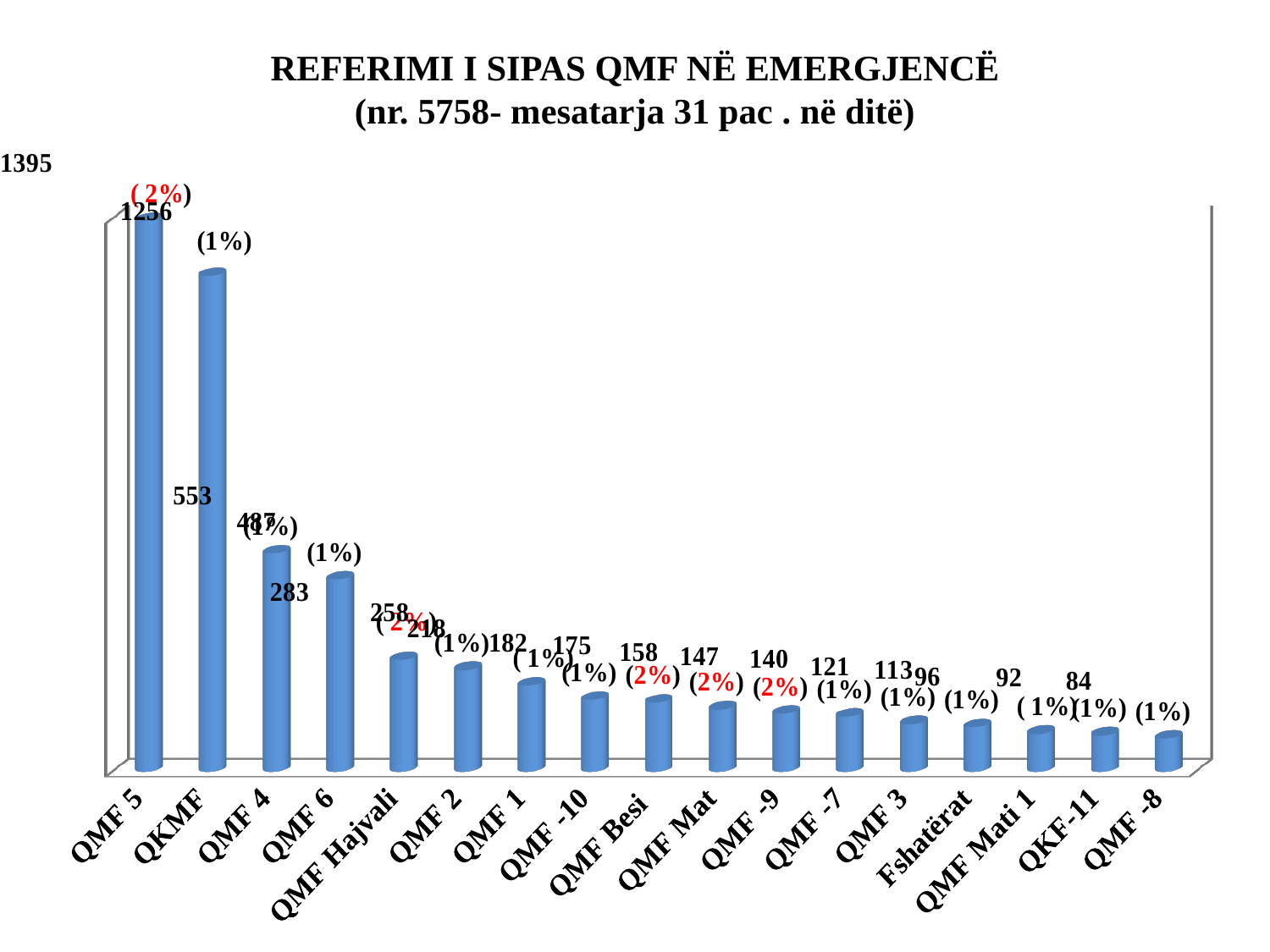
What is the largest data value printed on the chart? 1395 Which is larger, the value for QKMF or the value for QMF 4? QKMF Which is larger, the value for QMF Hajvali or the value for QMF 6? QMF 6 What total number (nr.) is given in the chart title? 5758 What kind of chart is shown on the slide? bar chart What daily average of patients is stated in the chart title? 31 Which category has the highest value in the chart? QMF 5 Which category has the lowest value in the chart? QMF -8 Do the values rise or fall moving from left to right along the x axis? fall What is the smallest data value printed on the chart? 84 How many categories (bars) are shown in the chart? 17